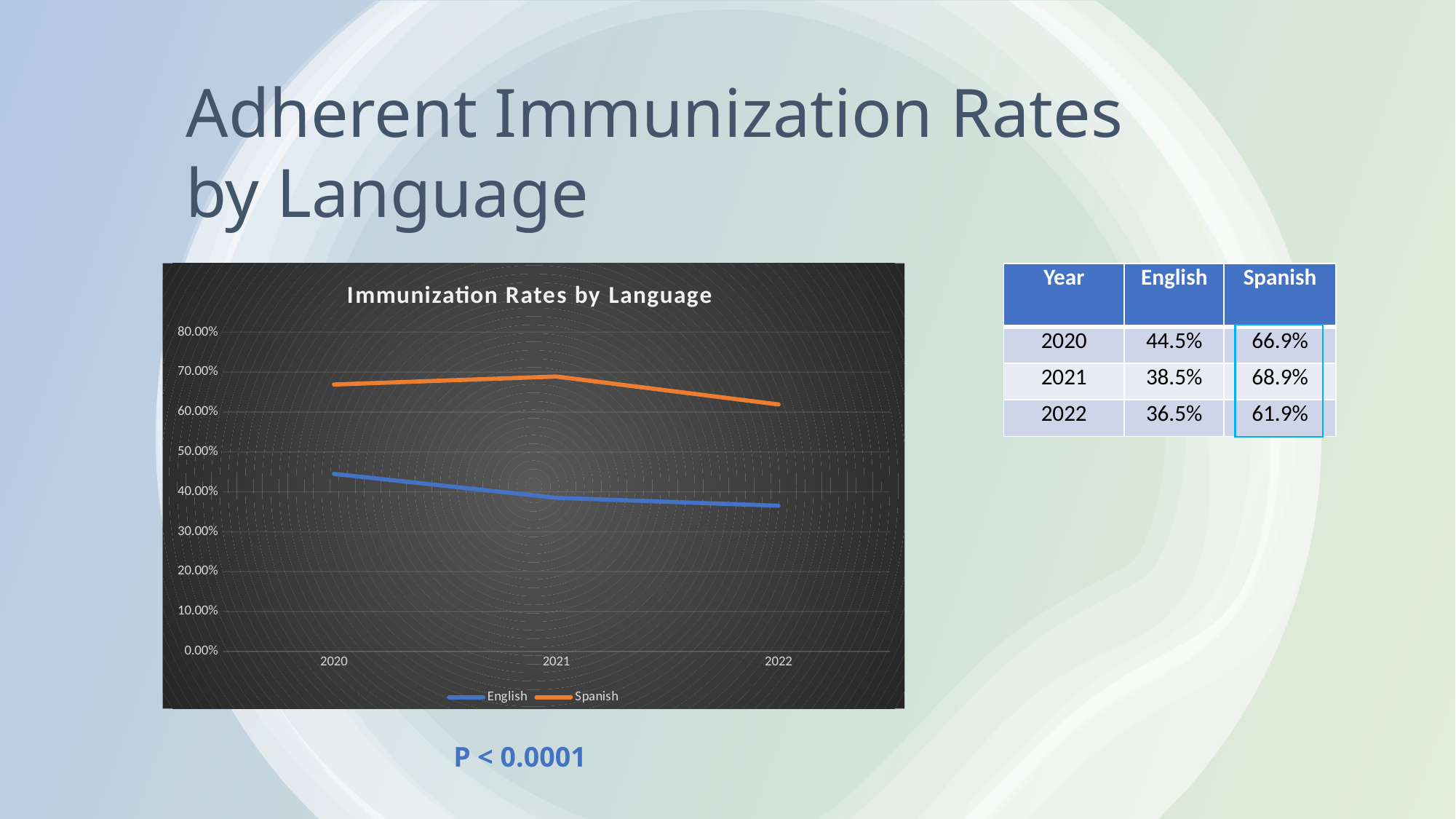
How many years are plotted along the x axis of the chart? 3 In which year is the Spanish immunization rate highest? 2021 In which year is the English immunization rate lowest? 2022 What is the difference between the Spanish and English immunization rates in 2022? 25.4% What is the English immunization rate for 2022? 36.5% Does the English immunization rate rise or fall from 2020 to 2022? fall What is the title of the chart? Immunization Rates by Language Which series has the higher immunization rate in 2020, English or Spanish? Spanish What is the English immunization rate for 2020? 44.5% What type of chart is shown on the slide? line chart What is the Spanish immunization rate for 2021? 68.9% How many series does the chart legend list? 2